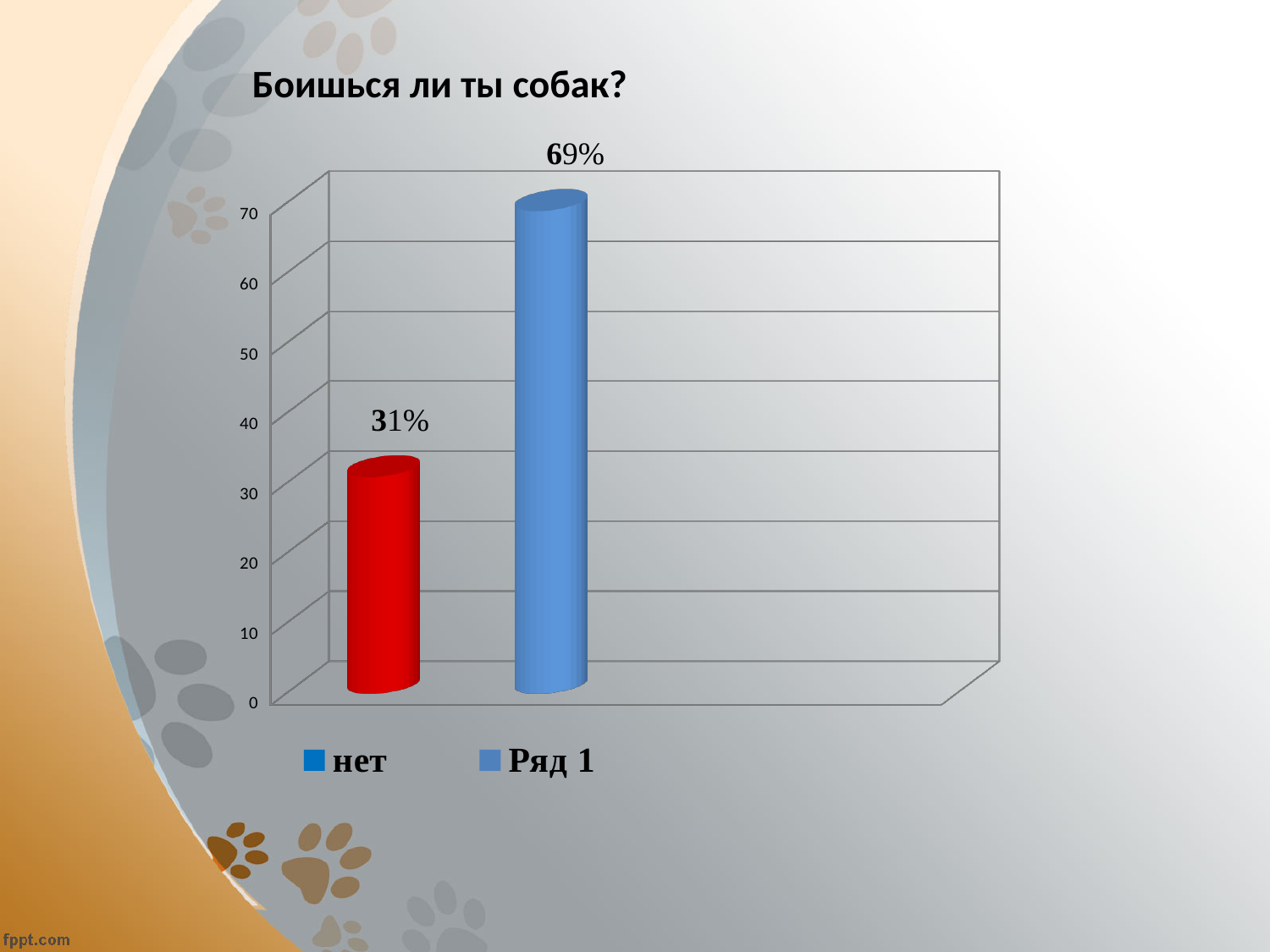
Is the value of the red bar larger or smaller than the value of the blue bar? smaller What is the difference between the blue bar's value and the red bar's value? 38% What kind of chart is shown on the slide? bar chart What is the value shown on the red bar? 31% How many bars are plotted in the chart? 2 Is the value of the blue bar greater or less than 60? greater Which bar has the highest value, the red one or the blue one? the blue bar What is the value shown on the blue bar? 69% How many entries does the legend list? 2 Is the value of the red bar greater or less than 40? less Which bar has the lowest value, the red one or the blue one? the red bar What is the title of the chart? Боишься ли ты собак?